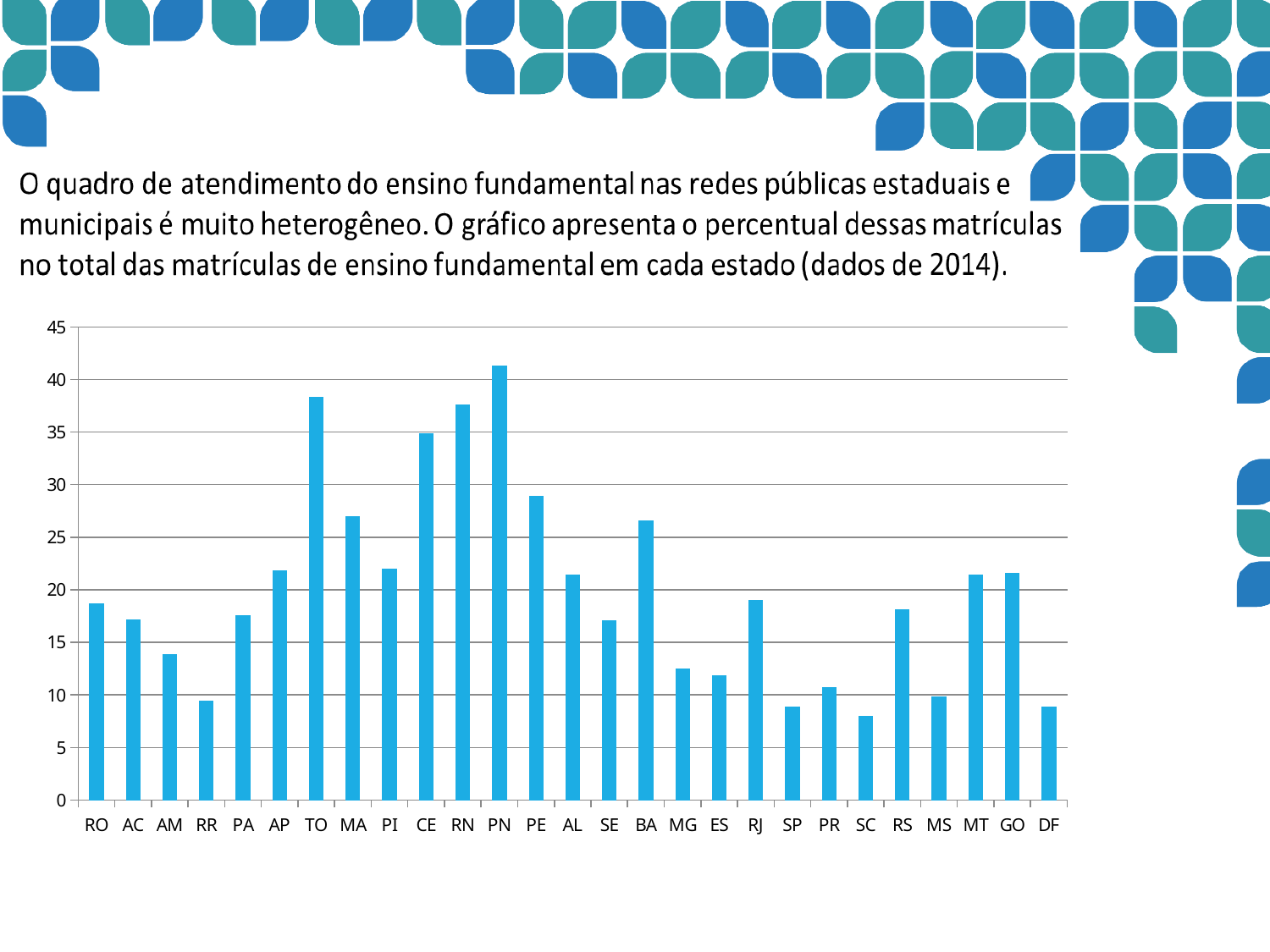
What kind of chart is shown on the slide? bar chart How many states (categories) are shown on the x axis of the chart? 27 Which state has the lowest bar in the chart? SC Is the value for SP greater or less than 10? less Which is larger, the value for TO or the value for MA? TO Is the value for RR greater or less than 10? less Which is larger, the value for RN or the value for PE? RN Is the value for TO greater or less than 35? greater What is the highest value shown on the y axis of the chart? 45 Which state has the highest bar in the chart? PN